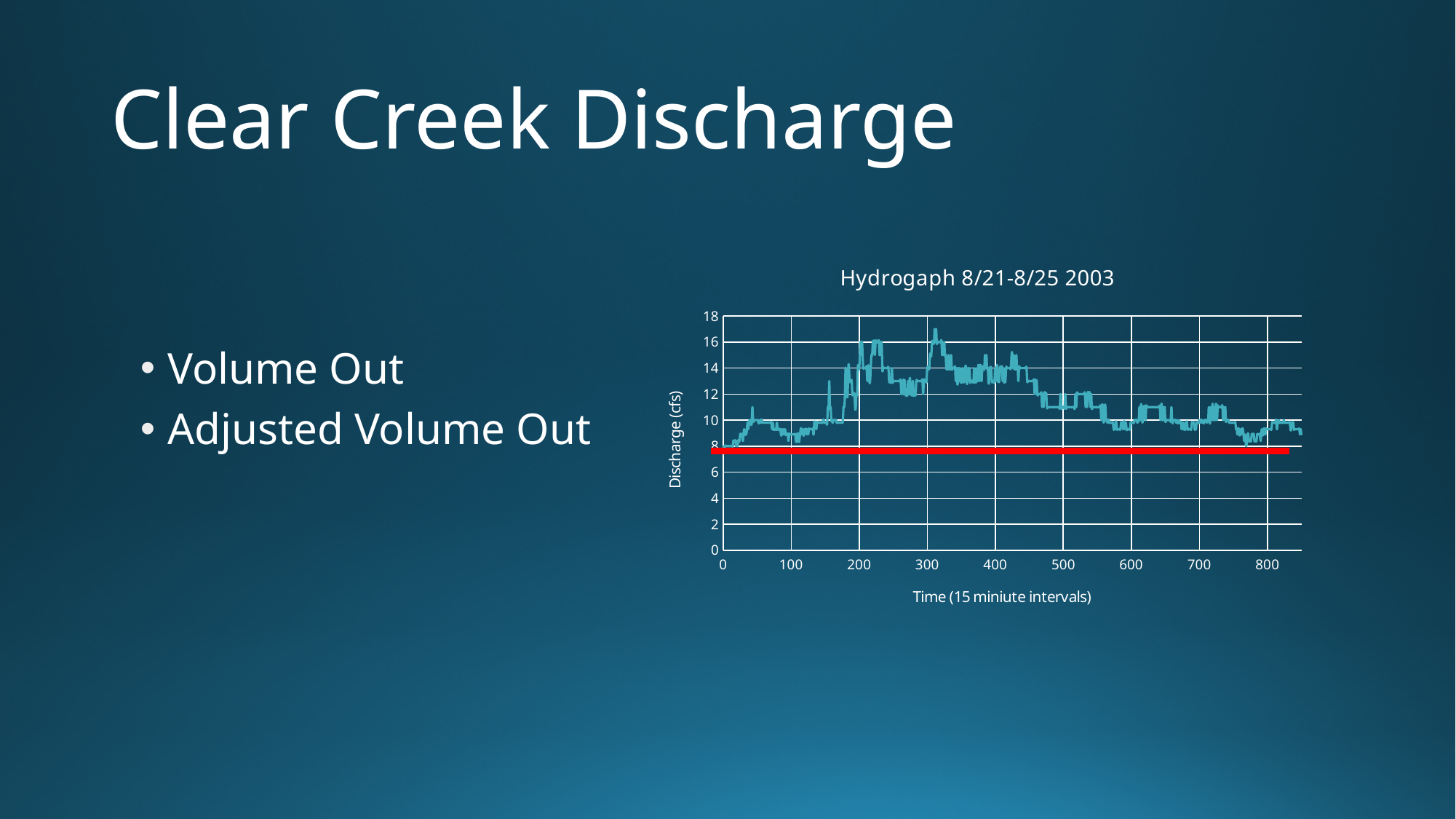
Does the discharge rise or fall between time 100 and time 200? rise Is the discharge value at time 0 greater or less than 10? less What is the label of the vertical axis of the chart? Discharge (cfs) What kind of chart is shown on the slide? line chart Is the discharge value at time 400 greater or less than 12? greater Is the discharge value at time 800 greater or less than 12? less Does the discharge rise or fall between time 400 and time 600? fall What is the highest value shown on the vertical axis? 18 What is the title of the chart? Hydrogaph 8/21-8/25 2003